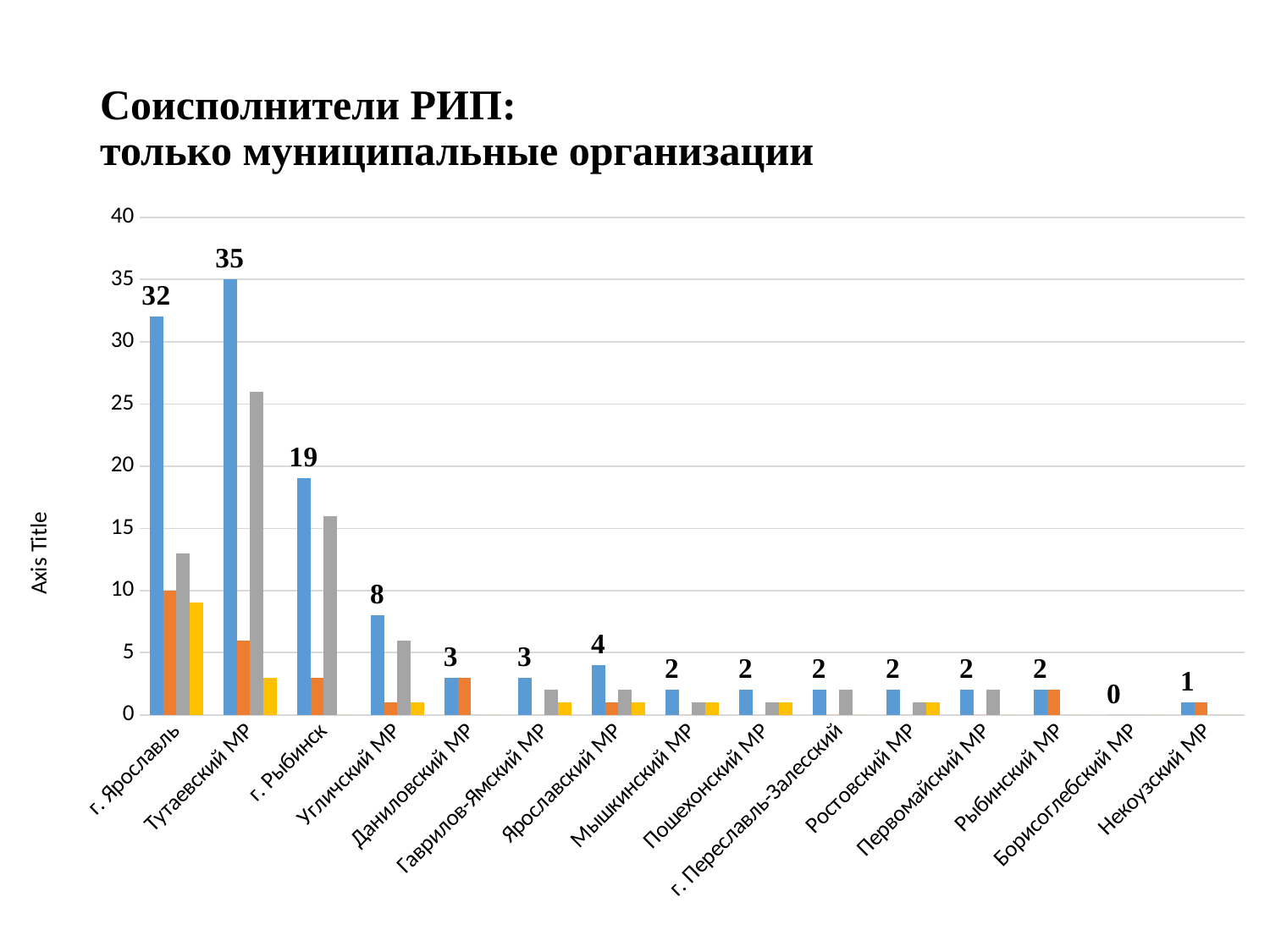
What type of chart is shown on the slide? bar chart Is the gray bar for Тутаевский МР greater or less than 25? greater What is the labelled value of the blue bar for г. Ярославль? 32 What is the labelled value of the blue bar for Угличский МР? 8 Which category has the highest labelled blue bar? Тутаевский МР What is the title of the chart? Соисполнители РИП: только муниципальные организации What is the difference between the labelled blue values for Тутаевский МР and г. Ярославль? 3 Which category has the lowest labelled blue bar? Борисоглебский МР How many categories are shown on the x axis? 15 Which has a larger labelled blue value, г. Рыбинск or Угличский МР? г. Рыбинск What is the labelled value of the blue bar for Тутаевский МР? 35 What is the labelled value of the blue bar for г. Рыбинск? 19